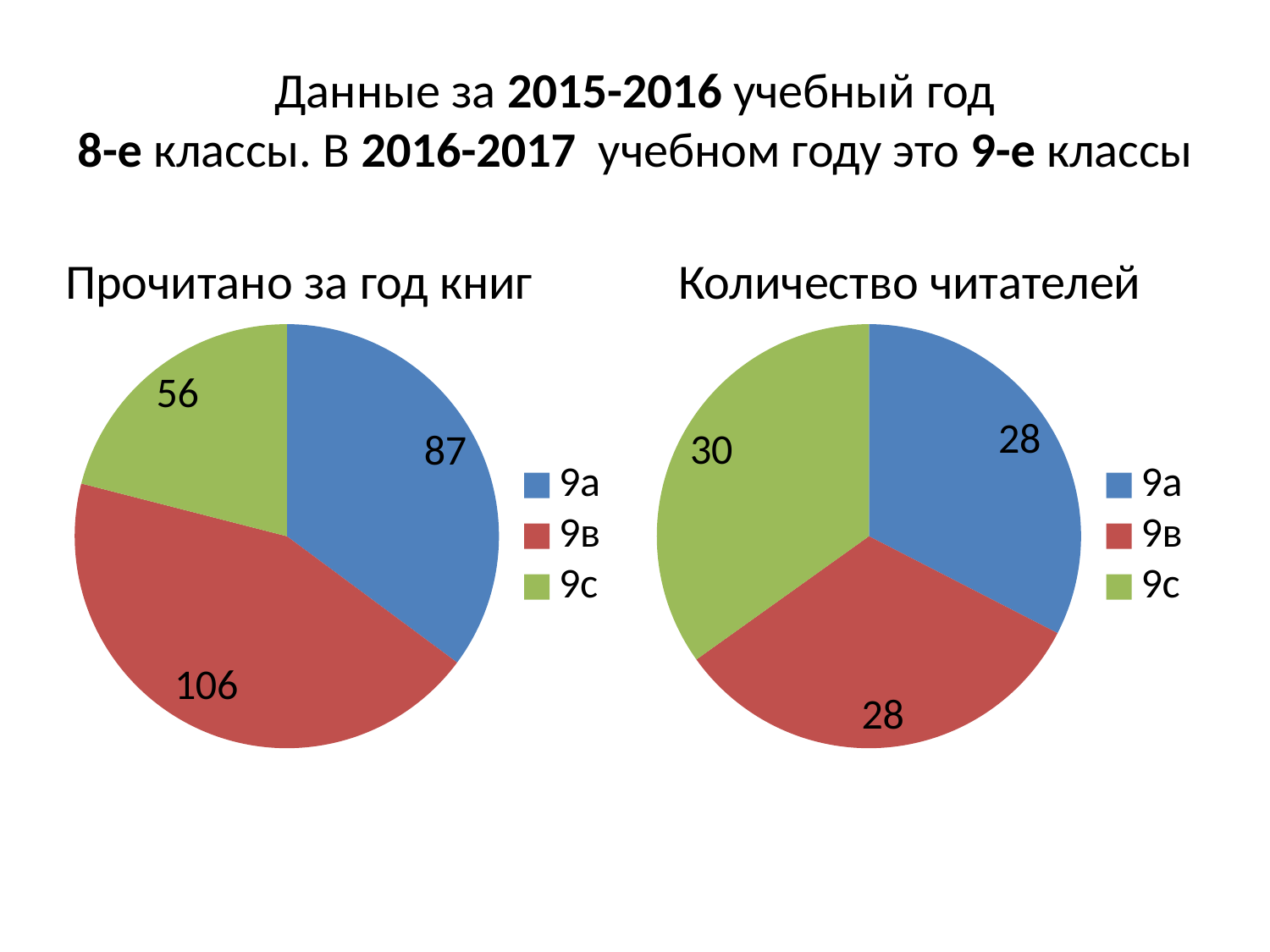
In the chart titled "Прочитано за год книг", what is the total of all slices? 249 In the chart titled "Прочитано за год книг", which class has the smallest slice? 9с In the chart titled "Количество читателей", what is the value for 9с? 30 In the chart titled "Прочитано за год книг", what is the value for 9с? 56 In the chart titled "Количество читателей", what is the difference between the values for 9с and 9а? 2 In the chart titled "Прочитано за год книг", what is the difference between the values for 9в and 9а? 19 In the chart titled "Прочитано за год книг", how many books did class 9в read? 106 In the chart titled "Прочитано за год книг", which is larger, the value for 9а or the value for 9с? 9а In the chart titled "Прочитано за год книг", which class has the largest slice? 9в How many slices does the chart titled "Количество читателей" have? 3 What type of chart is the chart titled "Прочитано за год книг"? pie chart In the chart titled "Количество читателей", what colour is the slice for 9в? red